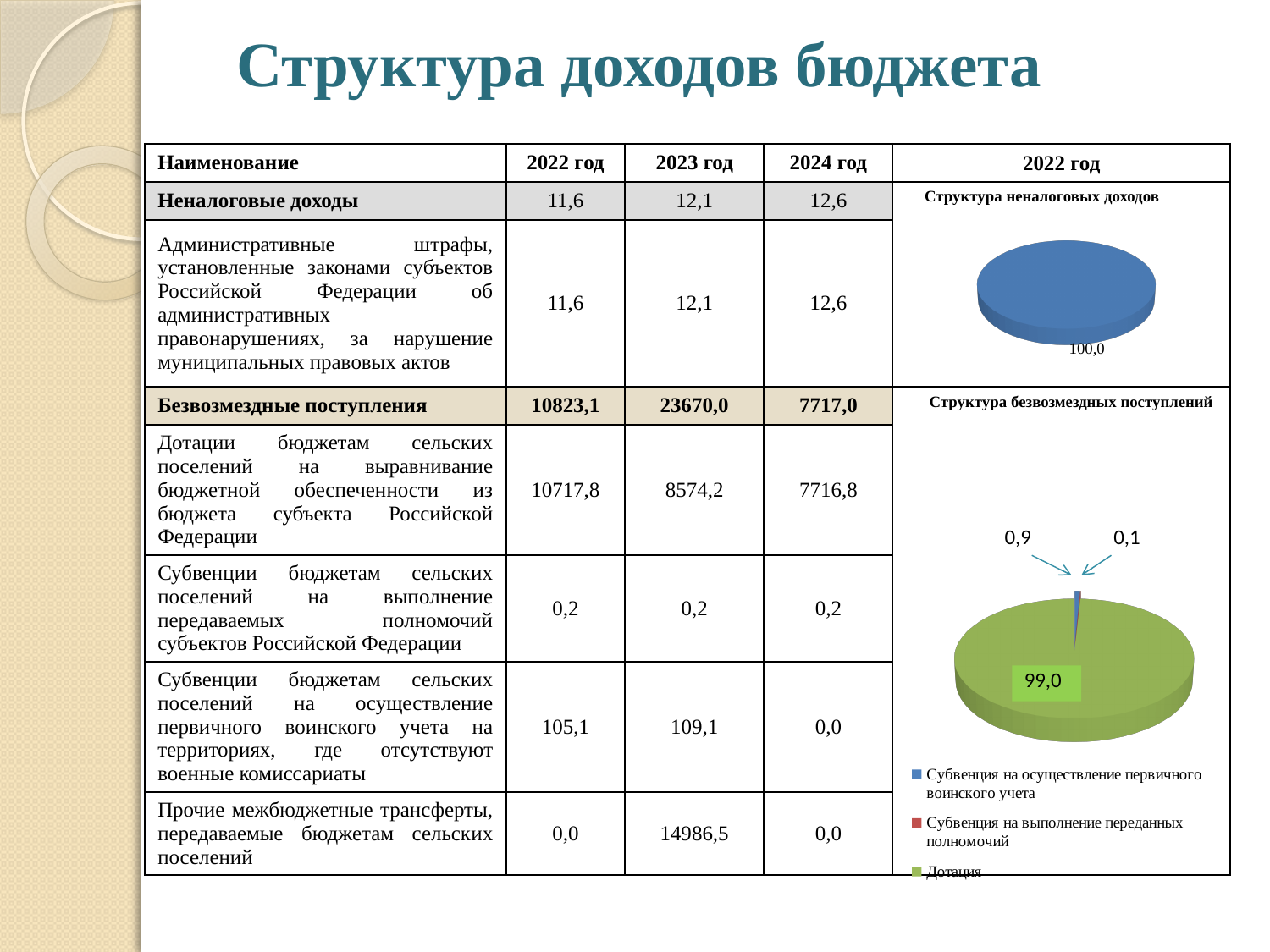
What kind of chart is the "Структура неналоговых доходов" chart? pie chart What value is labelled on the single slice of the "Структура неналоговых доходов" chart? 100,0 In the "Структура безвозмездных поступлений" chart, what is the difference between the Дотация value and the 0,9 value? 98,1 How many entries does the legend of the "Структура безвозмездных поступлений" chart list? 3 In the "Структура безвозмездных поступлений" chart, what value is labelled for the red slice (Субвенция на выполнение переданных полномочий)? 0,1 In the "Структура безвозмездных поступлений" chart, which category has the smallest share? Субвенция на выполнение переданных полномочий What colour is the Дотация slice in the "Структура безвозмездных поступлений" chart? green In the "Структура безвозмездных поступлений" chart, what value is shown for the largest slice (Дотация)? 99,0 In the "Структура безвозмездных поступлений" chart, what value is labelled for the blue slice (Субвенция на осуществление первичного воинского учета)? 0,9 How many slices does the "Структура неналоговых доходов" chart have? 1 What kind of chart is the "Структура безвозмездных поступлений" chart? pie chart In the "Структура безвозмездных поступлений" chart, which category has the largest share? Дотация